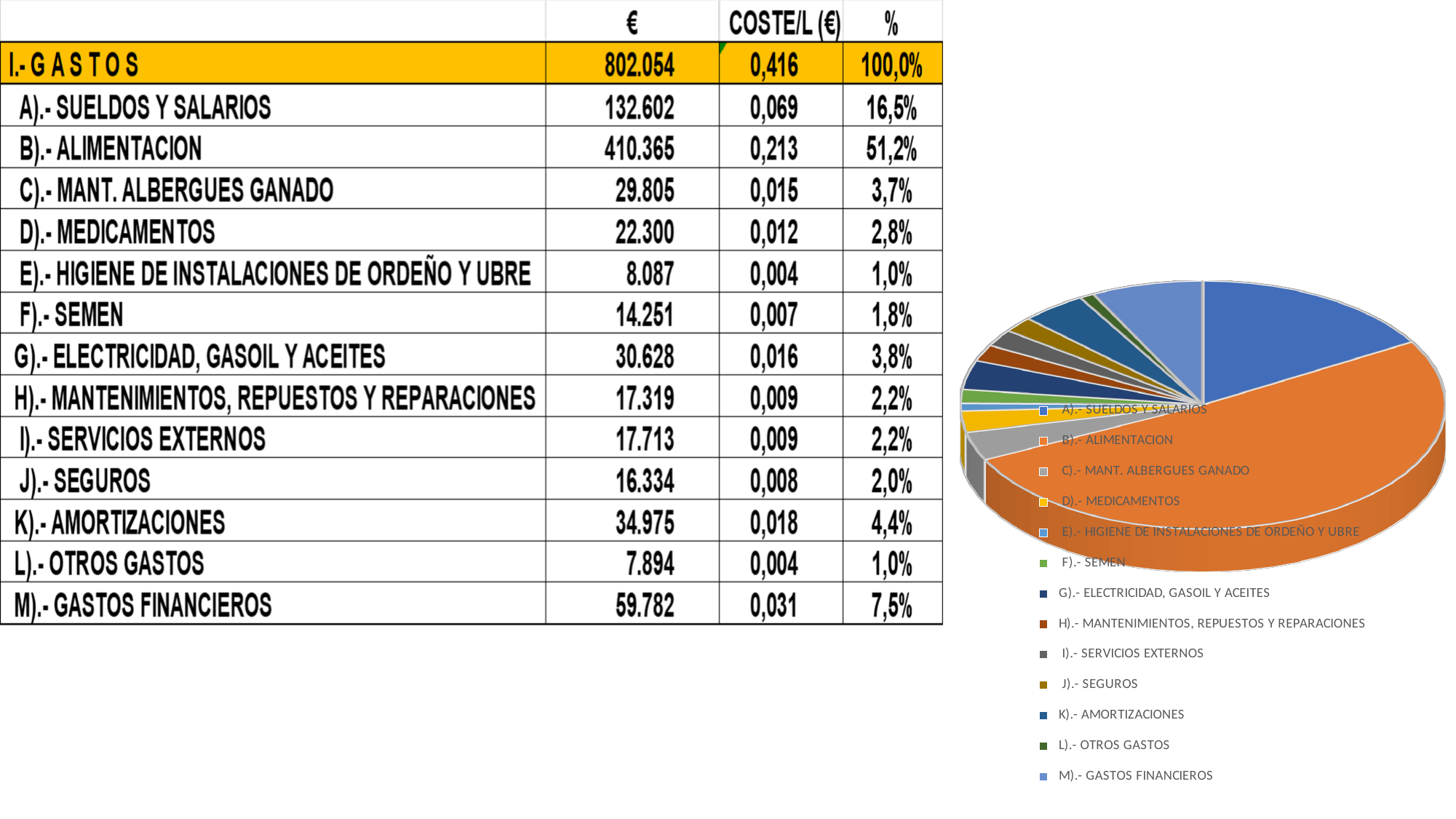
Which slice is larger in the pie chart: A).- SUELDOS Y SALARIOS or M).- GASTOS FINANCIEROS? A).- SUELDOS Y SALARIOS What is the € value for M).- GASTOS FINANCIEROS in the table? 59.782 How many expense categories (A to M) are listed in the table? 13 How many entries does the legend of the pie chart list? 13 According to the table, what share of total expenses does A).- SUELDOS Y SALARIOS represent? 16,5% Which category has the largest slice in the pie chart? B).- ALIMENTACION According to the table, what share of total expenses (GASTOS) does B).- ALIMENTACION represent? 51,2% What is the difference in € between B).- ALIMENTACION and A).- SUELDOS Y SALARIOS in the table? 277.763 What is the COSTE/L (€) value for K).- AMORTIZACIONES in the table? 0,018 What kind of chart is shown on the right of the slide? pie chart What is the total € value of I.- GASTOS in the table? 802.054 What colour is the slice for B).- ALIMENTACION in the pie chart? orange